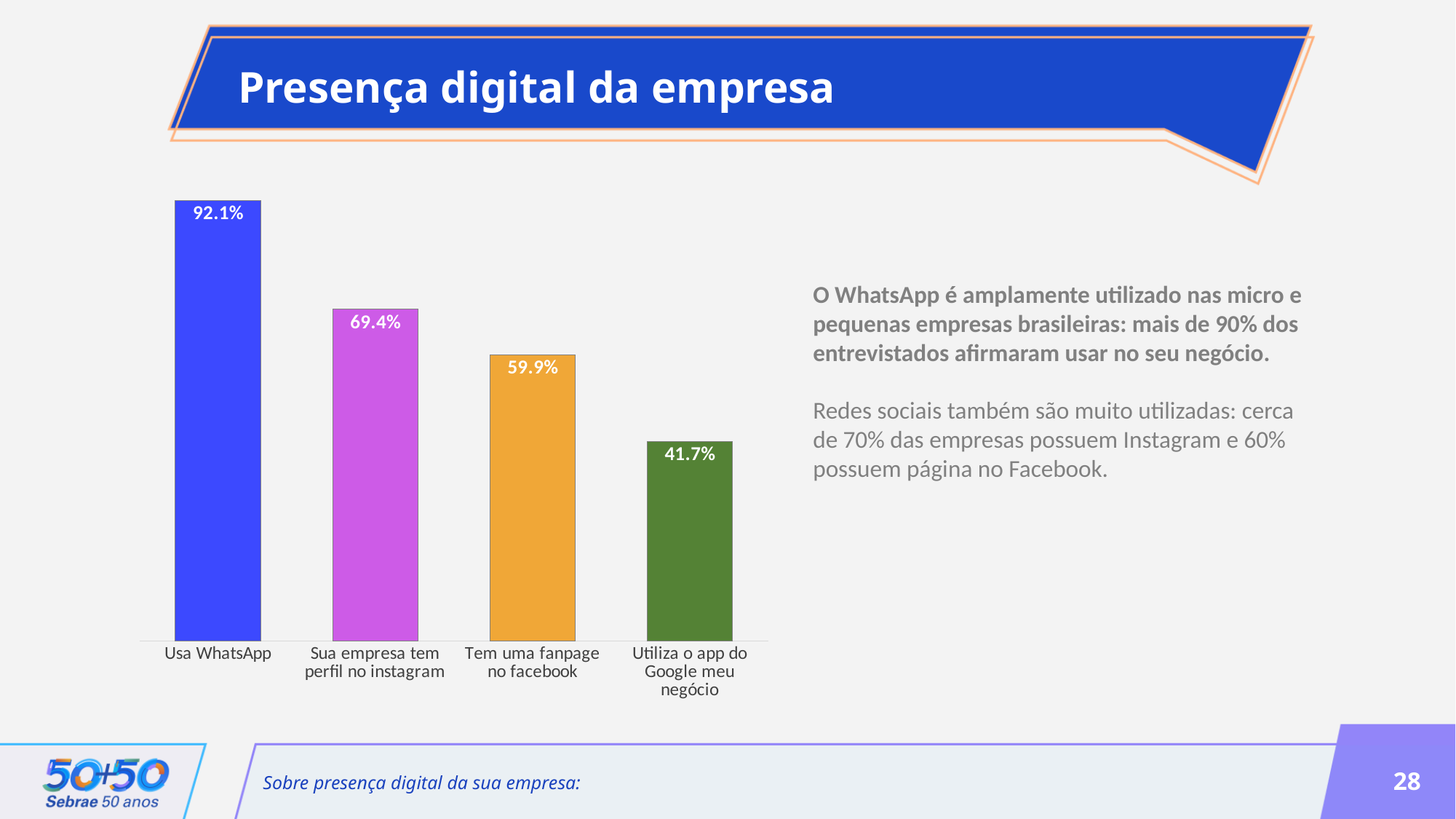
Do the values rise or fall from left to right across the categories? Fall How many categories are shown in the chart? 4 What is the difference between the values for "Tem uma fanpage no facebook" and "Utiliza o app do Google meu negócio"? 18.2% Which category has the lowest value? Utiliza o app do Google meu negócio What kind of chart is shown on the slide? Bar chart What is the difference between the values for "Usa WhatsApp" and "Sua empresa tem perfil no instagram"? 22.7% What is the value for "Utiliza o app do Google meu negócio"? 41.7% What is the value for "Usa WhatsApp"? 92.1% Which is larger: the value for "Sua empresa tem perfil no instagram" or for "Tem uma fanpage no facebook"? Sua empresa tem perfil no instagram What is the value for "Sua empresa tem perfil no instagram"? 69.4% Which category has the highest value? Usa WhatsApp What is the value for "Tem uma fanpage no facebook"? 59.9%